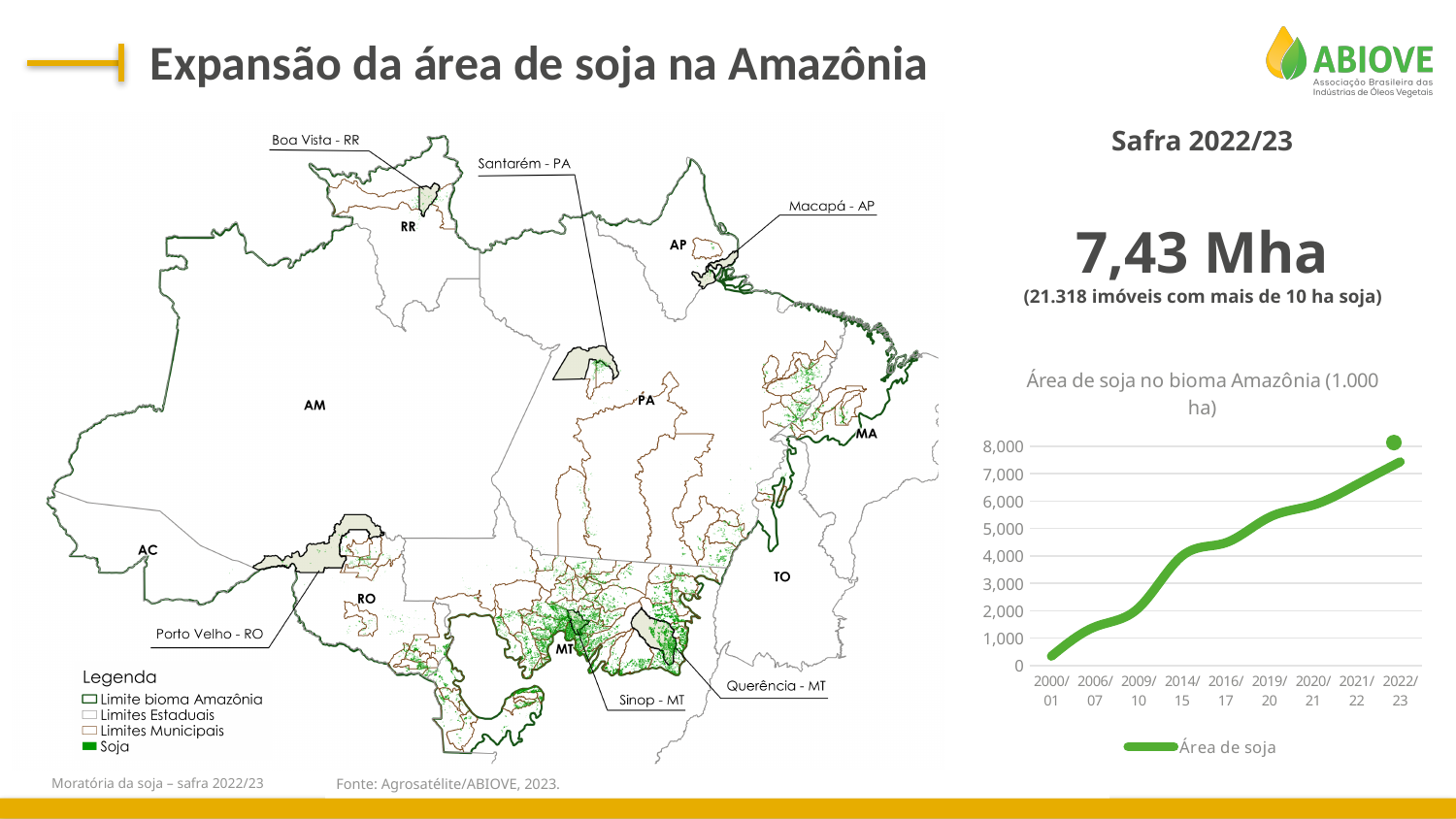
What is the title of the line chart? Área de soja no bioma Amazônia (1.000 ha) How many series does the legend of the line chart list? 1 What is the name of the series in the line chart's legend? Área de soja In the line chart, is the value for 2014/15 greater or less than 3,000? greater Does the soy area in the line chart rise or fall from 2000/01 to 2022/23? rise Which season has the lowest value in the line chart? 2000/01 In the line chart, which is larger, the value for 2009/10 or the value for 2019/20? 2019/20 Which season has the highest value in the line chart? 2022/23 What kind of chart is shown on the right side of the slide? line chart How many points (seasons) are labelled on the x axis of the line chart? 9 In the line chart, is the value for 2022/23 greater or less than 7,000? greater In the line chart, is the value for 2000/01 greater or less than 1,000? less